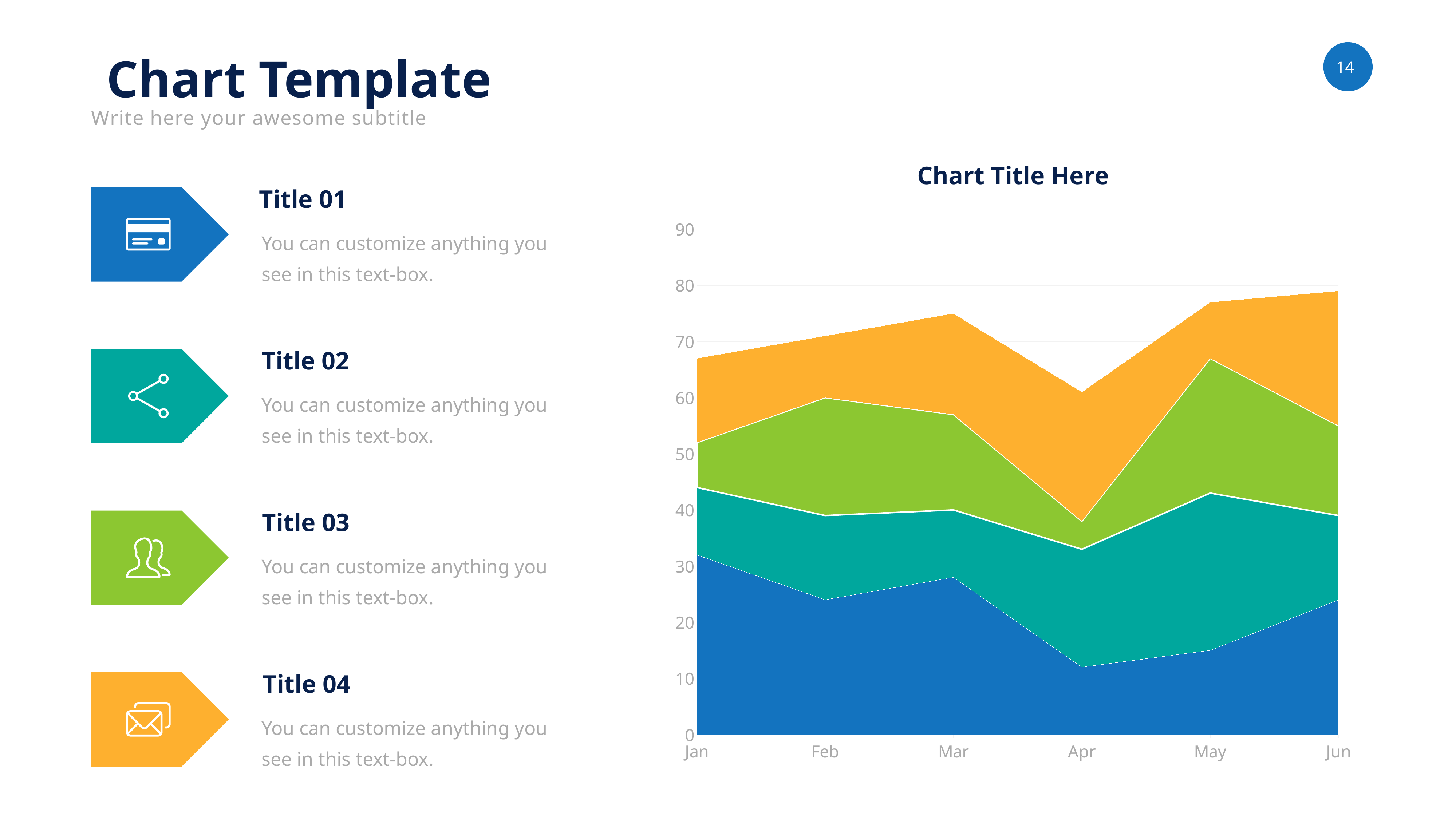
In which month is the bottom (blue) series lowest? Apr What kind of chart is shown on the slide? stacked area chart In which month is the top of the stacked areas lowest? Apr How many months are shown on the x axis of the chart? 6 Does the bottom (blue) series rise or fall from Jan to Apr? fall Is the top of the stacked areas in Apr greater or less than 70? less Is the bottom (blue) series larger in Jan or in Apr? Jan What is the title of the chart? Chart Title Here Is the top of the stacked areas in Jun greater or less than 70? greater What colour is the bottom area series in the chart? blue Is the value of the bottom (blue) series in Apr greater or less than 20? less